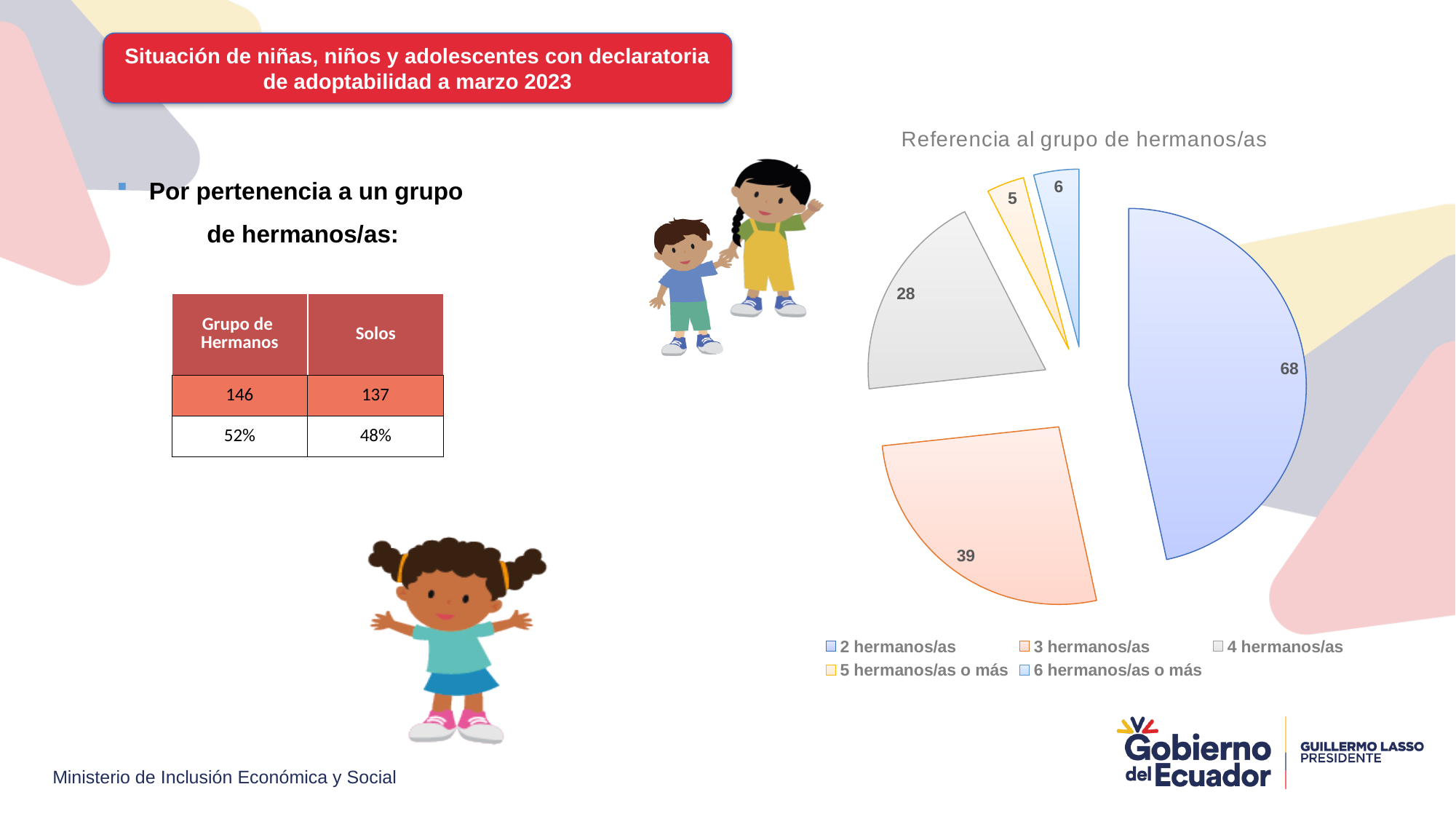
Which category has the largest slice in the pie chart? 2 hermanos/as Which category has the smallest slice in the pie chart? 5 hermanos/as o más What is the total of all the values shown in the pie chart? 146 What type of chart is shown on the slide? pie chart What is the value for the "6 hermanos/as o más" slice? 6 What is the value for the "2 hermanos/as" slice? 68 How many slices does the pie chart have? 5 Which is larger, the value for "4 hermanos/as" or the value for "3 hermanos/as"? 3 hermanos/as What is the difference between the values for "2 hermanos/as" and "3 hermanos/as"? 29 What is the title of the chart? Referencia al grupo de hermanos/as What is the value for the "3 hermanos/as" slice? 39 What is the value for the "4 hermanos/as" slice? 28